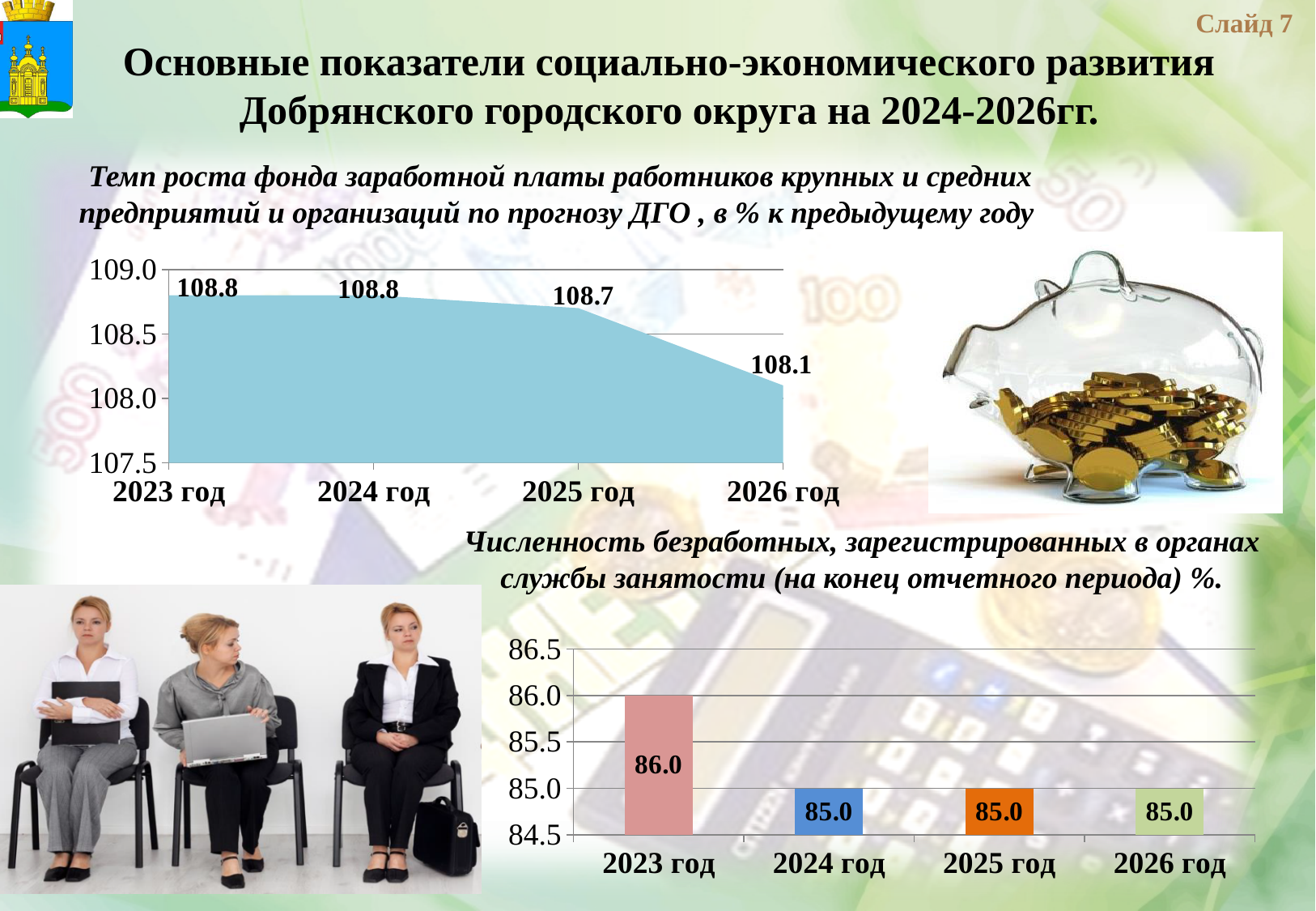
What kind of chart is the bottom chart (Численность безработных)? bar chart In the top chart (Темп роста фонда заработной платы), do the values rise or fall from 2023 год to 2026 год? fall How many years are shown in the bottom chart (Численность безработных)? 4 In the top chart (Темп роста фонда заработной платы), what is the difference between the values for 2025 год and 2026 год? 0.6 In the bottom chart (Численность безработных), what is the value for 2025 год? 85.0 In the top chart (Темп роста фонда заработной платы), what is the value for 2026 год? 108.1 In the top chart (Темп роста фонда заработной платы), which year has the lowest value? 2026 год In the bottom chart (Численность безработных), what is the difference between the values for 2023 год and 2024 год? 1.0 In the bottom chart (Численность безработных), what is the value for 2023 год? 86.0 In the bottom chart (Численность безработных), which year has the highest value? 2023 год What kind of chart is the top chart (Темп роста фонда заработной платы)? area chart In the top chart (Темп роста фонда заработной платы), what is the value for 2025 год? 108.7